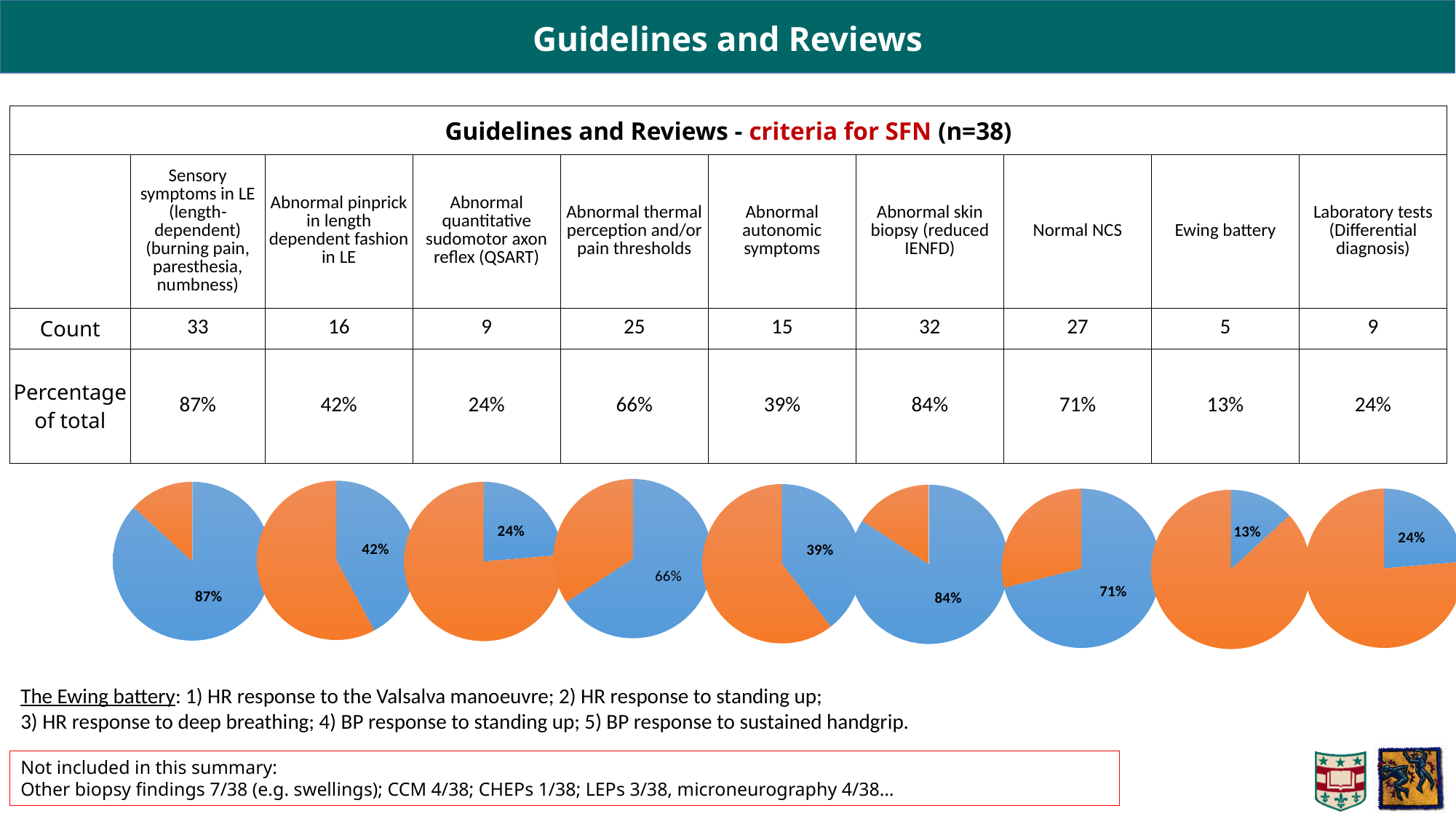
Which pie chart shows the smallest blue share? The Ewing battery pie, 13% What percentage is labelled on the pie chart under 'Ewing battery' (eighth from the left)? 13% What percentage is labelled on the pie chart under 'Normal NCS' (seventh from the left)? 71% Is the blue share larger in the pie under 'Abnormal skin biopsy (reduced IENFD)' or in the pie under 'Abnormal autonomic symptoms'? Abnormal skin biopsy (reduced IENFD) What percentage is labelled on the fourth pie chart from the left, under 'Abnormal thermal perception and/or pain thresholds'? 66% How many pie charts are shown on the slide? 9 What percentage is labelled on the first (leftmost) pie chart, under 'Sensory symptoms in LE'? 87% What percentage is labelled on the second pie chart from the left, under 'Abnormal pinprick in length dependent fashion in LE'? 42% What two colours are used for the slices in the pie charts? Blue and orange What is the difference between the percentage labelled on the first pie chart (87%) and the percentage labelled on the Ewing battery pie chart (13%)? 74% What kind of charts are shown in the row beneath the table? Pie charts Which pie chart shows the largest blue share? The first (leftmost) pie, Sensory symptoms in LE, 87%